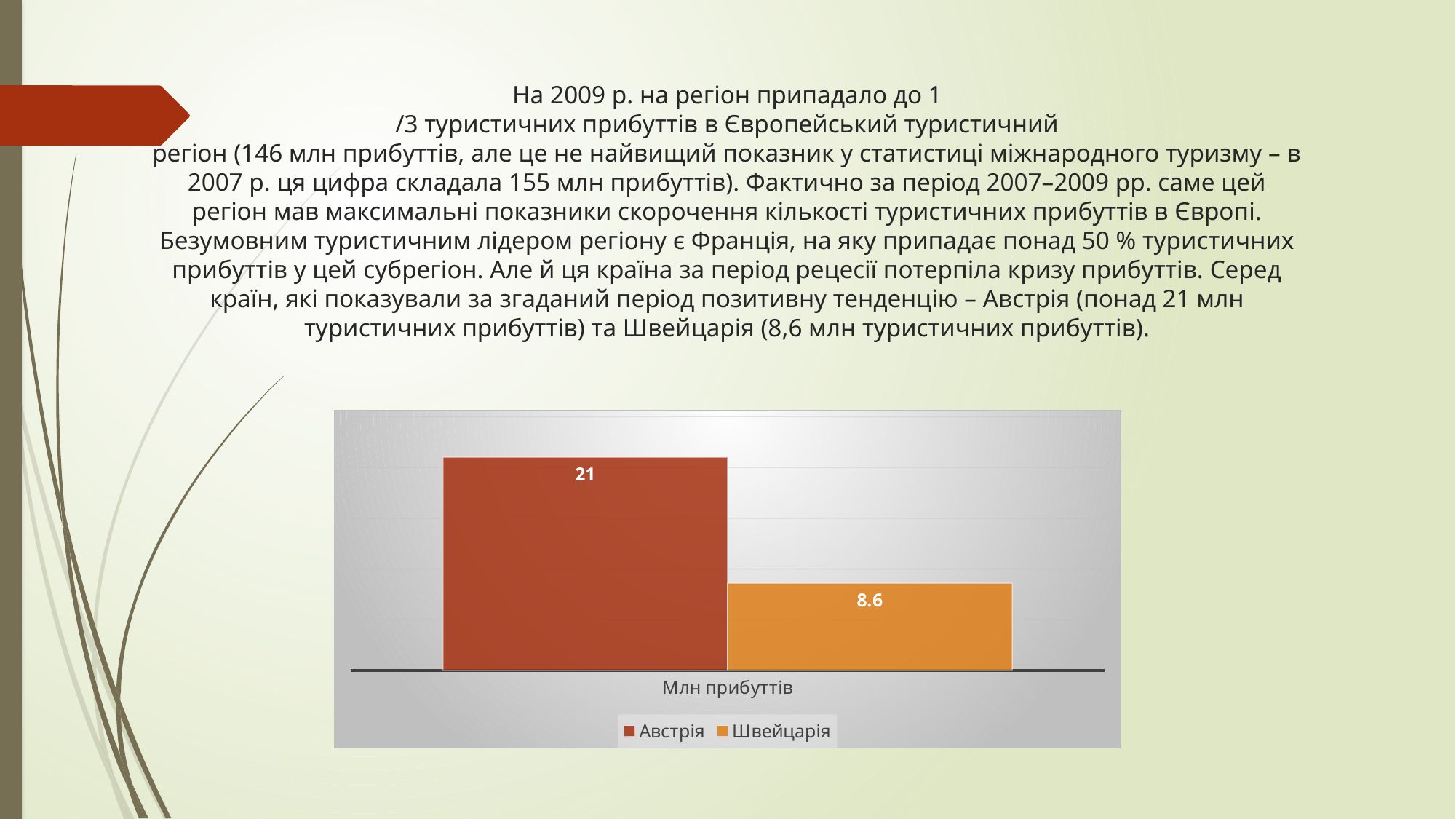
Which series has the lowest value in the chart? Швейцарія What is the category label shown on the x axis of the chart? Млн прибуттів What kind of chart is shown on the slide? bar chart How many bars are plotted in the chart? 2 What is the value for Австрія in the chart? 21 Which series has the highest value in the chart? Австрія What is the value for Швейцарія in the chart? 8.6 Which is larger, the value for Австрія or the value for Швейцарія? Австрія What colour is the bar for Швейцарія? orange What is the difference between the values for Австрія and Швейцарія? 12.4 How many series does the legend list? 2